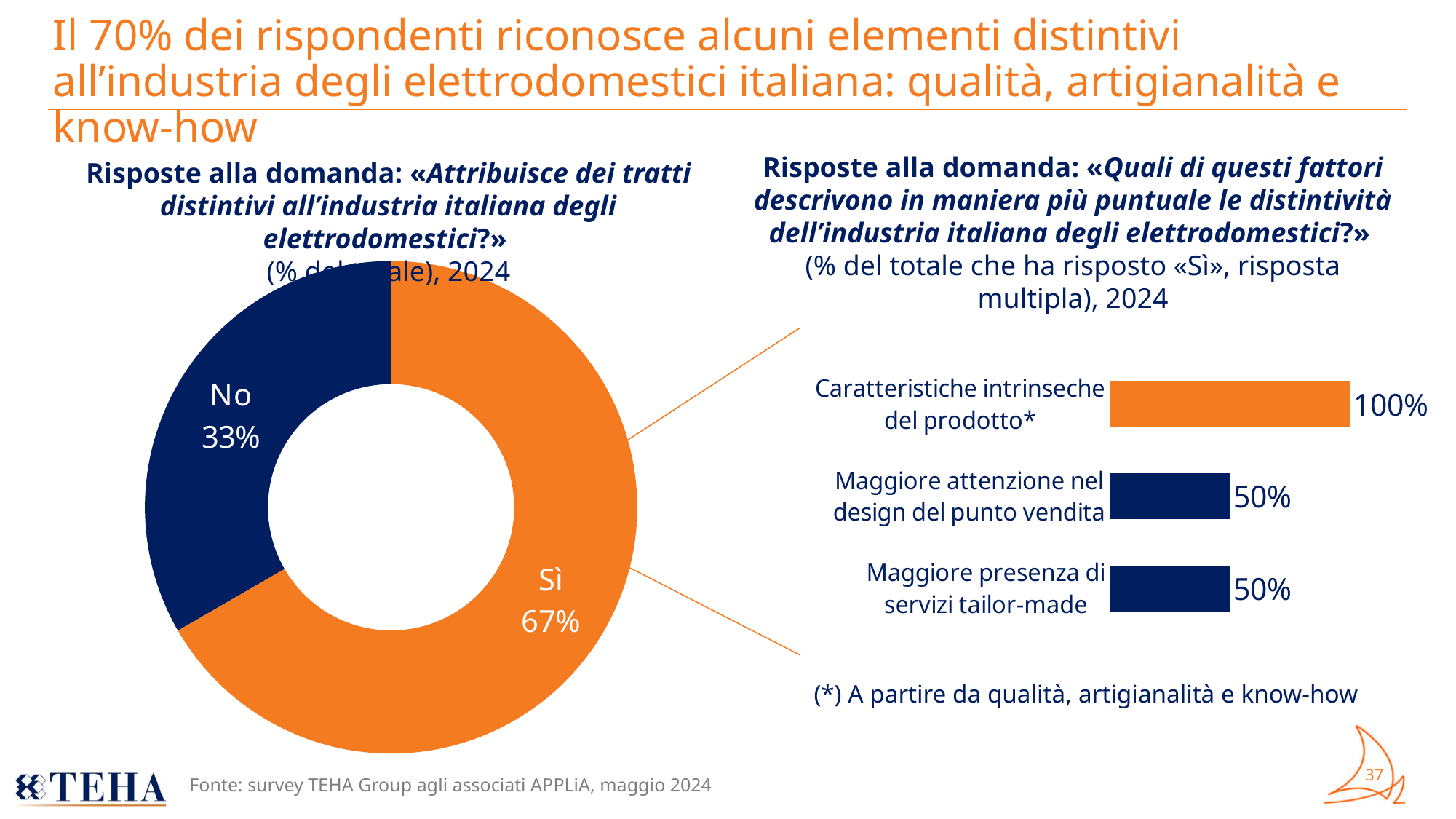
In the donut chart on the left, what percentage of respondents answered "Sì"? 67% In the bar chart on the right, what is the value for "Caratteristiche intrinseche del prodotto*"? 100% What type of chart is shown on the left of the slide? Donut (pie) chart What type of chart is shown on the right of the slide? Bar chart In the bar chart on the right, which category has the highest value? Caratteristiche intrinseche del prodotto* In the donut chart on the left, what percentage of respondents answered "No"? 33% In the bar chart on the right, what is the difference between "Caratteristiche intrinseche del prodotto*" and "Maggiore presenza di servizi tailor-made"? 50 percentage points How many slices does the donut chart on the left have? 2 In the donut chart on the left, which answer has the larger share, "Sì" or "No"? Sì How many categories are shown in the bar chart on the right? 3 In the donut chart on the left, what is the difference in percentage points between "Sì" and "No"? 34 In the bar chart on the right, what is the value for "Maggiore attenzione nel design del punto vendita"? 50%